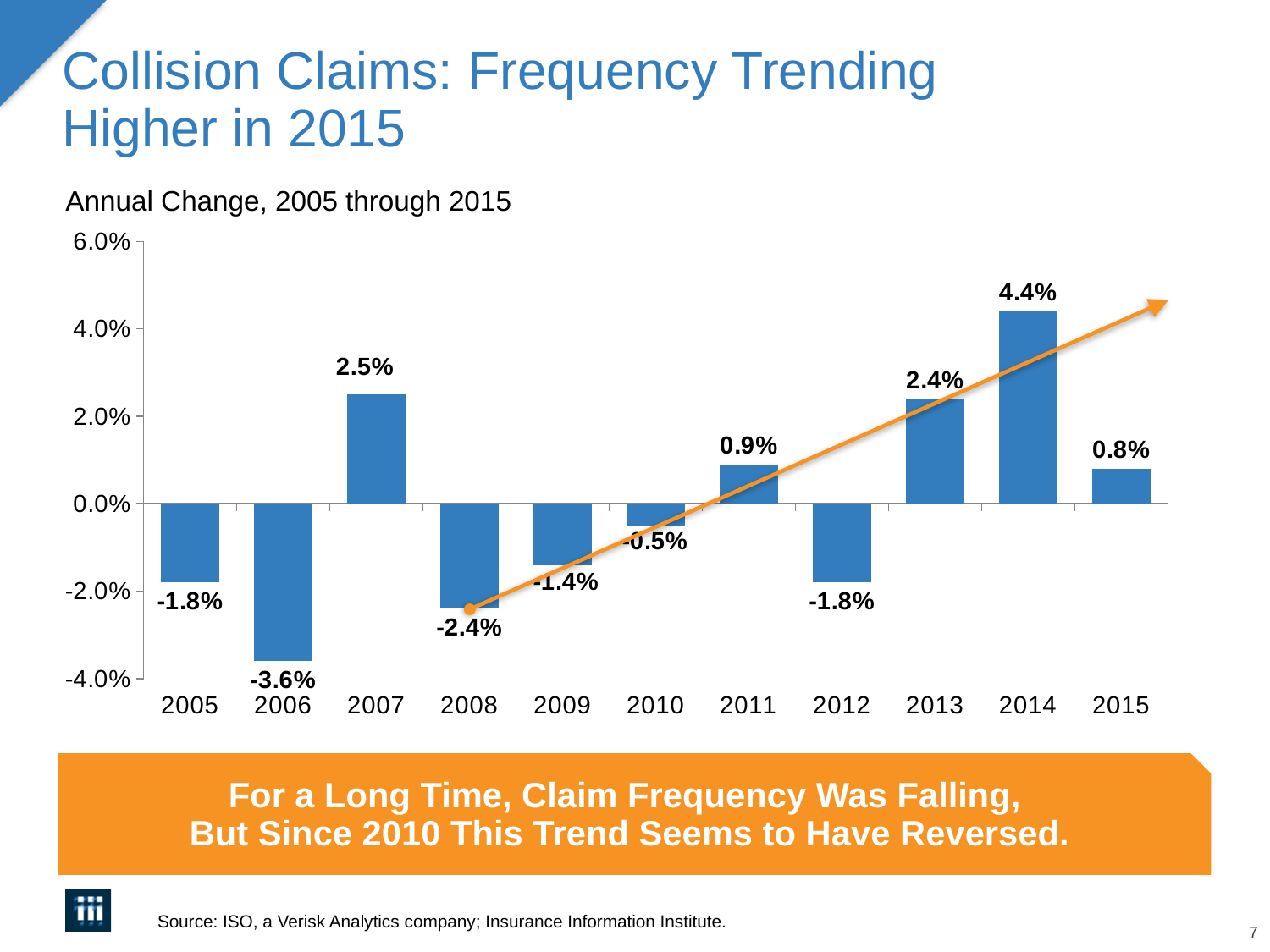
Which year has the highest annual change in collision claim frequency? 2014 What kind of chart is used to show the annual change in collision claim frequency? Bar chart Which year has the lowest annual change in collision claim frequency? 2006 Do the annual change values generally rise or fall from 2012 to 2014? Rise What is the annual change in collision claim frequency for 2006? -3.6% Which year has a larger annual change, 2007 or 2011? 2007 How many years are shown on the x axis of the chart? 11 What is the difference between the annual change in 2014 and the annual change in 2013? 2.0% What is the annual change in collision claim frequency for 2010? -0.5% What is the subtitle printed above the chart? Annual Change, 2005 through 2015 What is the annual change in collision claim frequency for 2014? 4.4% What is the annual change in collision claim frequency for 2015? 0.8%